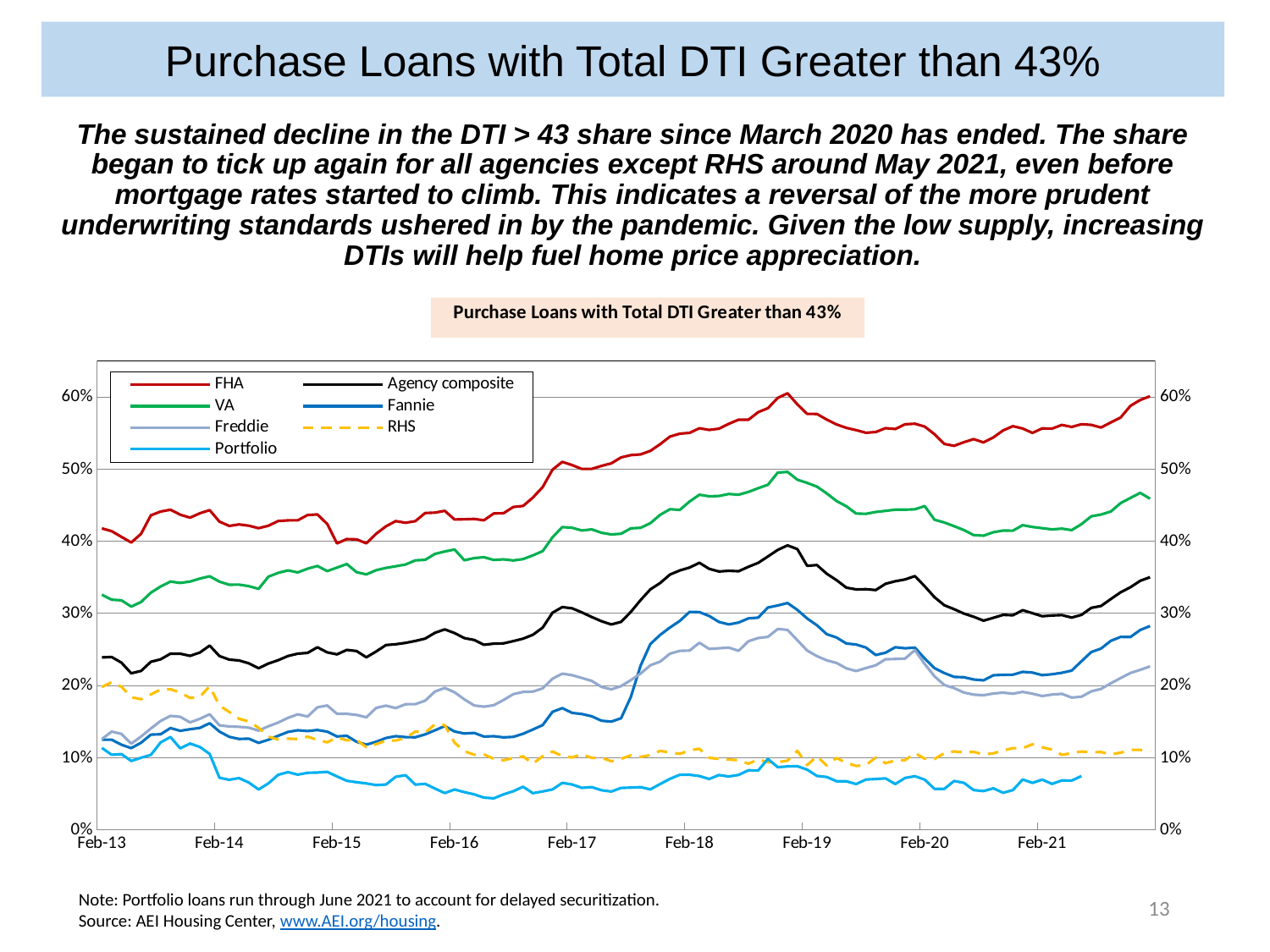
Which series has the highest values across the whole period? FHA Is the value for Portfolio at Feb-14 greater or less than 10%? less How many series does the legend list? 7 At Feb-19, which is higher, Fannie or Freddie? Fannie Is the value for FHA at Feb-13 greater or less than 40%? greater Which series has the lowest values for most of the period? Portfolio At Feb-17, which is higher, RHS or Portfolio? RHS What is the title of the chart? Purchase Loans with Total DTI Greater than 43% What kind of chart is shown on the slide? Line chart Does the Agency composite series rise or fall between Feb-19 and Feb-20? Fall Which series is drawn with a dashed line? RHS Is the value for Freddie at Feb-21 greater or less than 20%? less